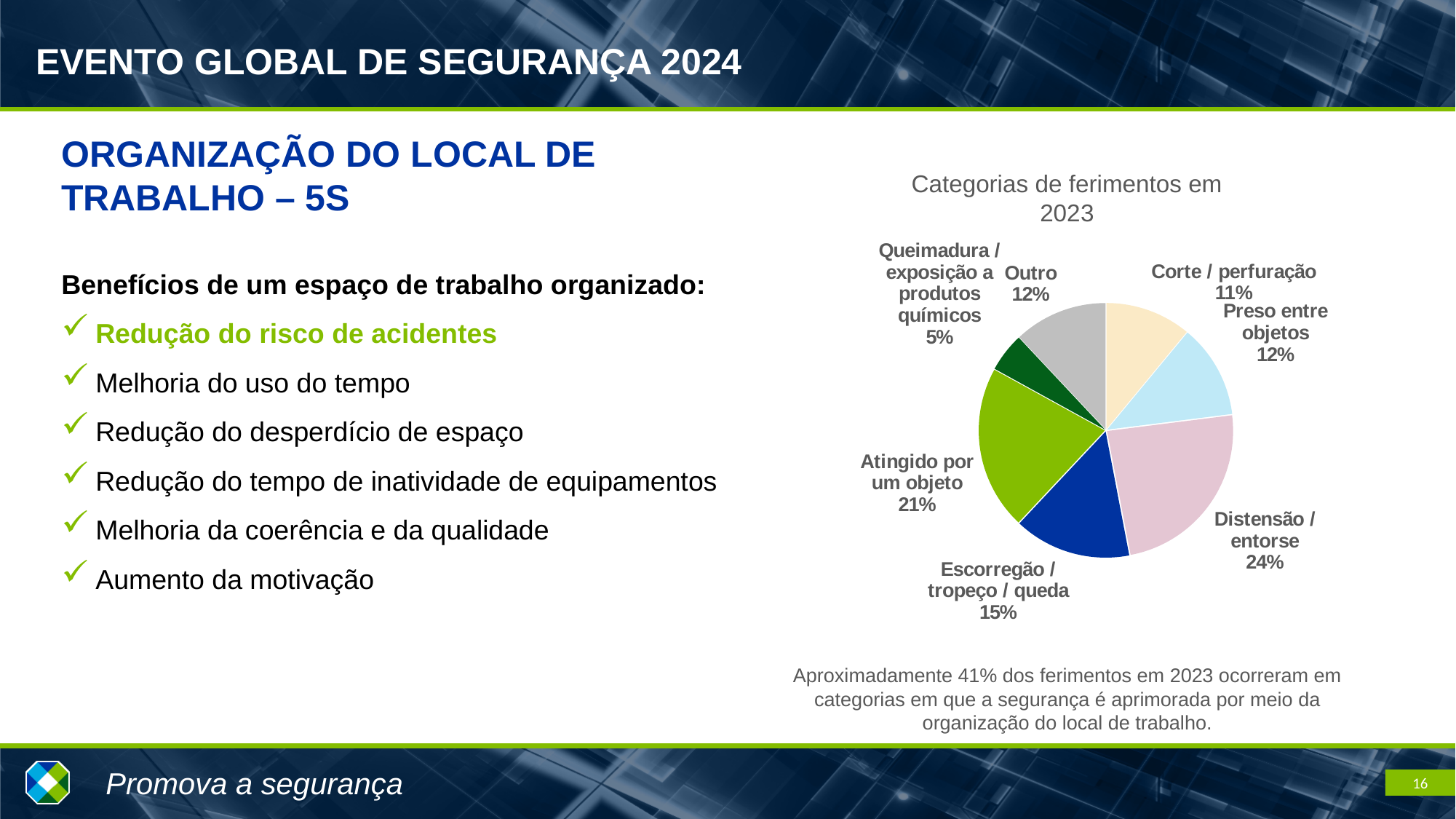
Which category has the smallest share of the pie? Queimadura / exposição a produtos químicos What is the title of the chart? Categorias de ferimentos em 2023 Which is larger, the share for "Atingido por um objeto" or the share for "Escorregão / tropeço / queda"? Atingido por um objeto What percentage is shown for "Atingido por um objeto"? 21% What share of injuries is attributed to "Distensão / entorse"? 24% What percentage is shown for "Queimadura / exposição a produtos químicos"? 5% What is the combined share of "Preso entre objetos" and "Outro"? 24% Which category has the largest share of the pie? Distensão / entorse How many categories are shown in the pie chart? 7 What percentage is shown for "Escorregão / tropeço / queda"? 15% What is the difference in percentage points between "Distensão / entorse" and "Corte / perfuração"? 13 What type of chart is shown on the slide? Pie chart